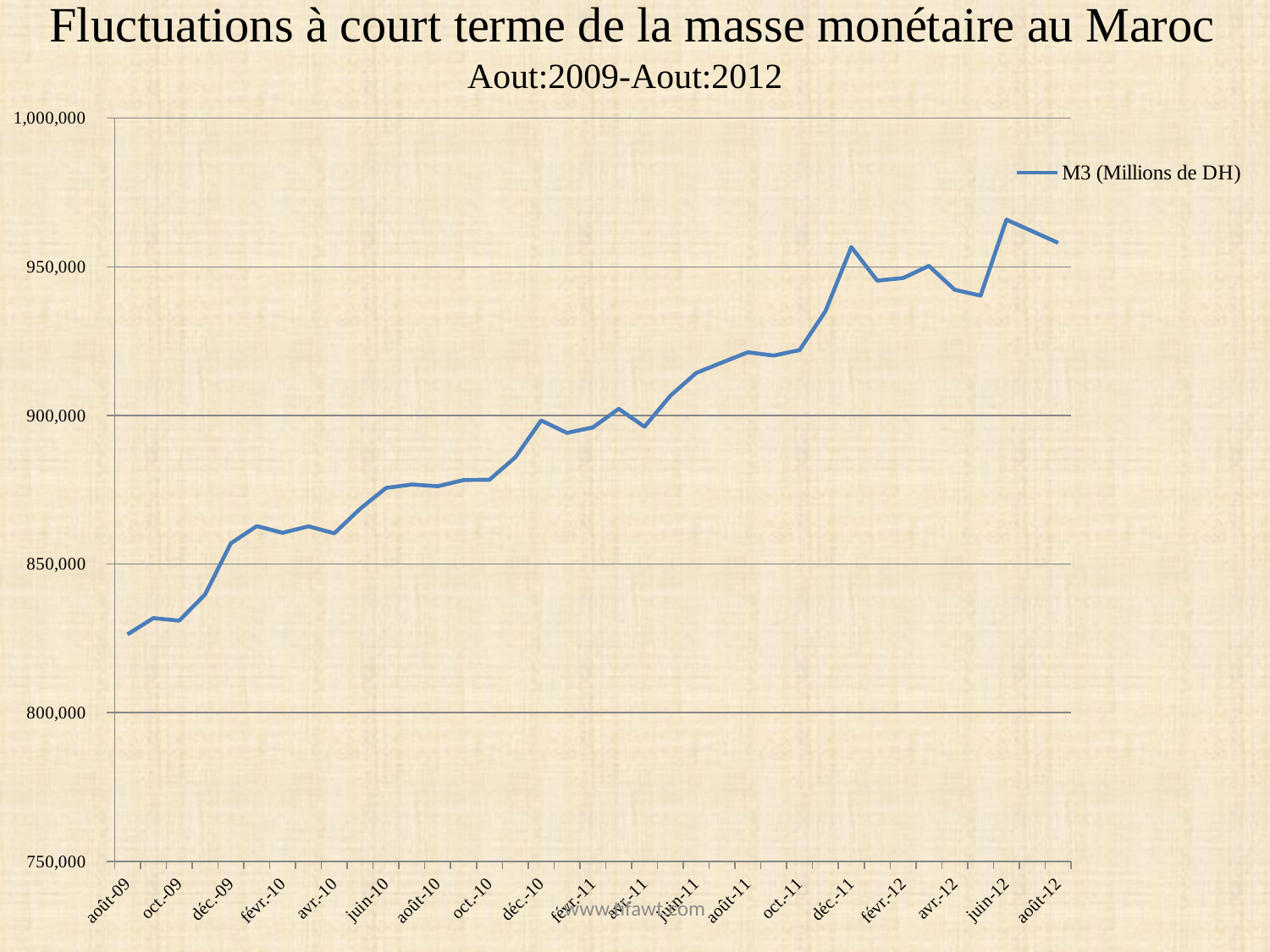
What is the title of the chart? Fluctuations à court terme de la masse monétaire au Maroc Aout:2009-Aout:2012 At which month does M3 reach its highest value? juin-12 Is the value for août-11 greater or less than 900,000? greater Which is larger, the M3 value for août-12 or for août-09? août-12 Is the value for juin-12 greater or less than 950,000? greater Is the value for août-09 greater or less than 850,000? less What is the name of the series shown in the legend? M3 (Millions de DH) How many series does the legend list? 1 What kind of chart is shown on the slide? line chart At which month is M3 at its lowest value? août-09 Overall, do the M3 values rise or fall from août-09 to août-12? rise